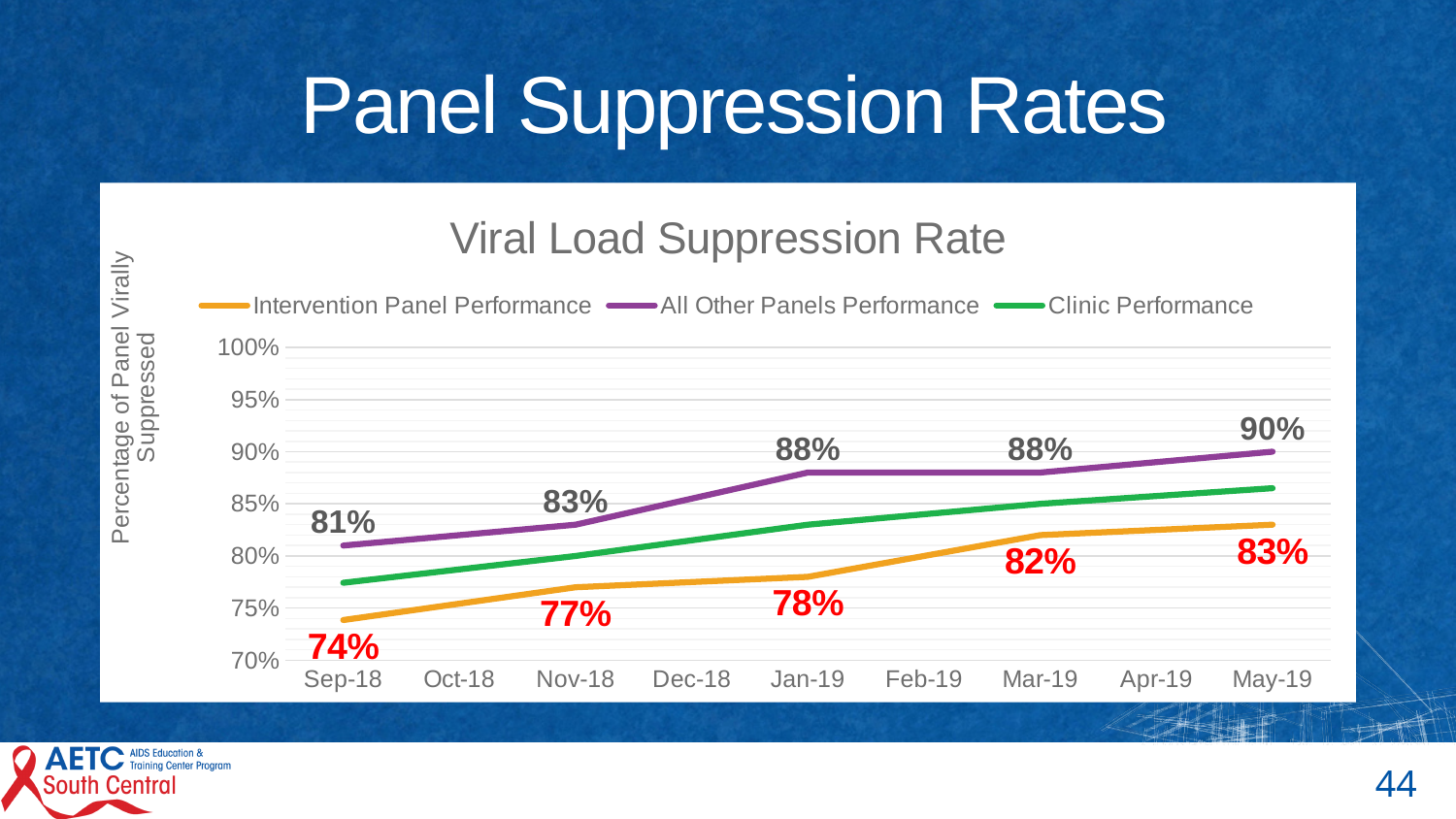
How many series does the legend list? 3 Does Intervention Panel Performance rise or fall from Sep-18 to May-19? Rise What is the title of the chart? Viral Load Suppression Rate What is the All Other Panels Performance value for May-19? 90% What is the difference between All Other Panels Performance and Intervention Panel Performance in Jan-19? 10% Which series is higher in Nov-18, Intervention Panel Performance or All Other Panels Performance? All Other Panels Performance By how much did Intervention Panel Performance increase from Sep-18 to May-19? 9% What is the Intervention Panel Performance value for Mar-19? 82% What is the Intervention Panel Performance value for Sep-18? 74% How many months are shown on the x axis? 9 What type of chart is shown on the slide? Line chart Is the Clinic Performance value for Sep-18 greater or less than 80%? less